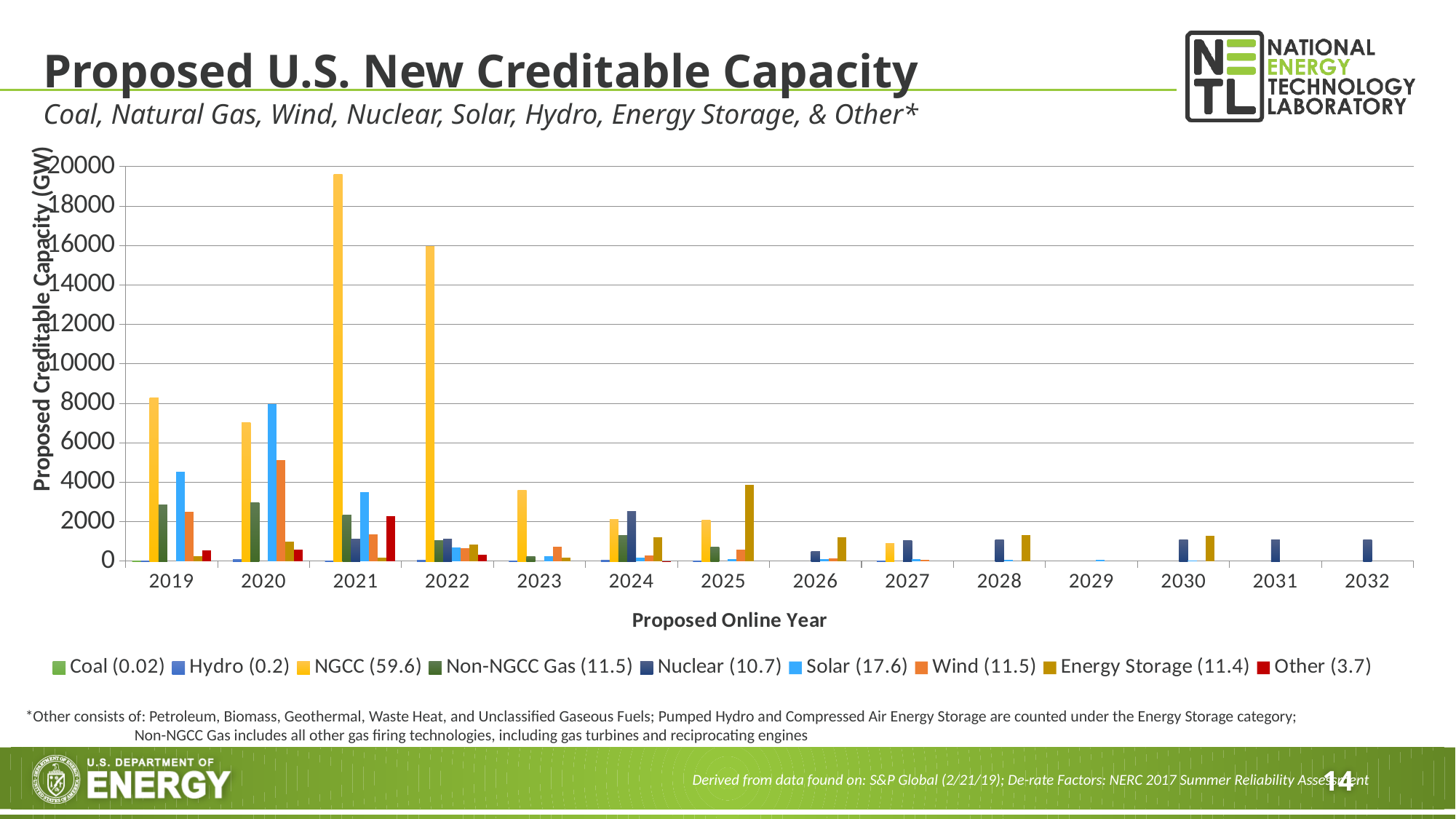
How many series does the legend list? 9 Is the Wind value for 2020 greater or less than 4000? greater Is the Solar value for 2020 greater or less than 6000? greater What kind of chart is shown on the slide? bar chart Which is larger in 2019, the Solar bar or the Wind bar? Solar In which year is the NGCC bar the highest? 2021 How many proposed online years are shown on the x axis? 14 Is the NGCC value for 2022 greater or less than 14000? greater What is the title of the x axis? Proposed Online Year Which series has the tallest bar in 2025? Energy Storage Which is larger, the NGCC value for 2019 or the NGCC value for 2020? 2019